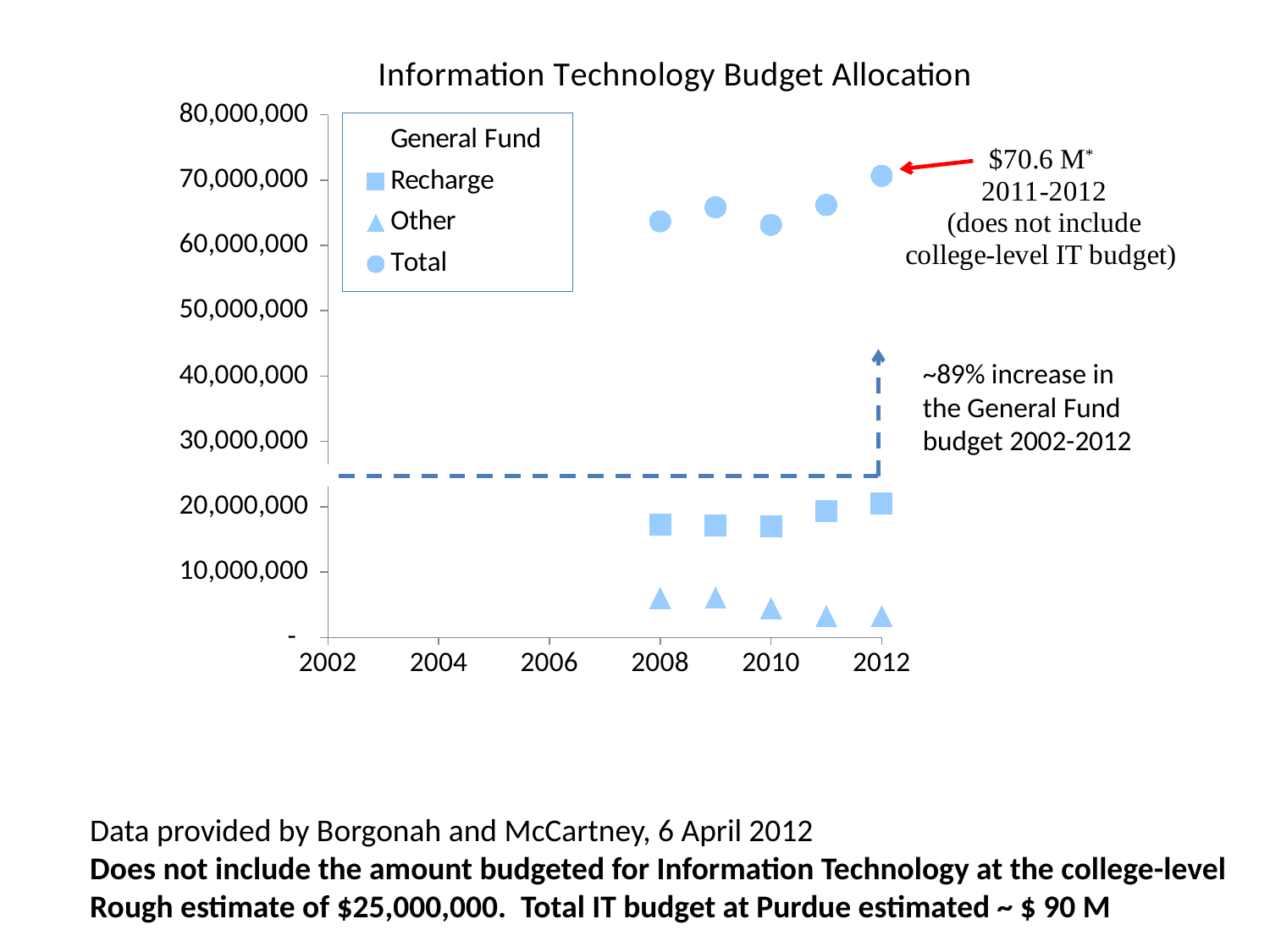
Is the Recharge value for 2008 greater or less than 20,000,000? less Is the Total value for 2008 greater or less than 60,000,000? greater How many Total data points are plotted on the chart? 5 Which is larger, the Total value for 2010 or the Total value for 2012? 2012 Which year has the highest Total value? 2012 Is the Other value for 2012 greater or less than 10,000,000? less What is the title of the chart? Information Technology Budget Allocation What is the labelled Total value for 2011-2012 on the chart? $70.6 M What kind of chart is shown on the slide? scatter chart Which is larger, the Recharge value for 2008 or the Recharge value for 2012? 2012 Do the Other series values rise or fall from 2008 to 2012? fall Which marker shape represents the Total series in the legend? circle